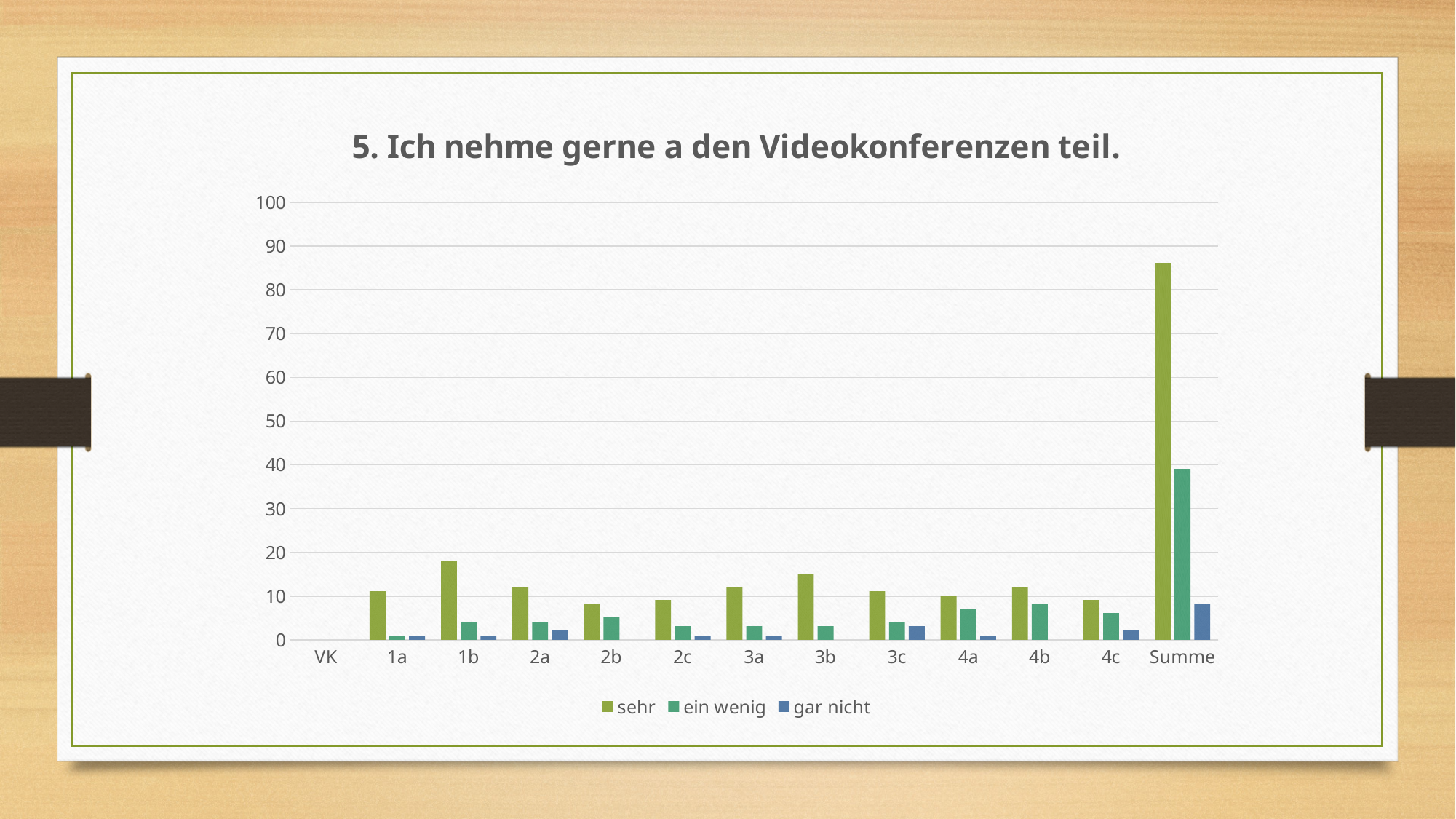
Is the 'sehr' value for 1b greater or less than 10? greater Excluding Summe, which category has the highest 'sehr' value? 1b What is the title of the chart? 5. Ich nehme gerne a den Videokonferenzen teil. Is the 'gar nicht' value for Summe greater or less than 10? less How many series does the legend list? 3 Which is larger, the 'sehr' value for 1b or the 'sehr' value for 2a? 1b Which is larger for Summe, the 'sehr' value or the 'ein wenig' value? sehr Which category has the highest value for the 'sehr' series? Summe What kind of chart is shown on the slide? bar chart Is the 'sehr' value for Summe greater or less than 80? greater How many categories are shown on the x axis? 13